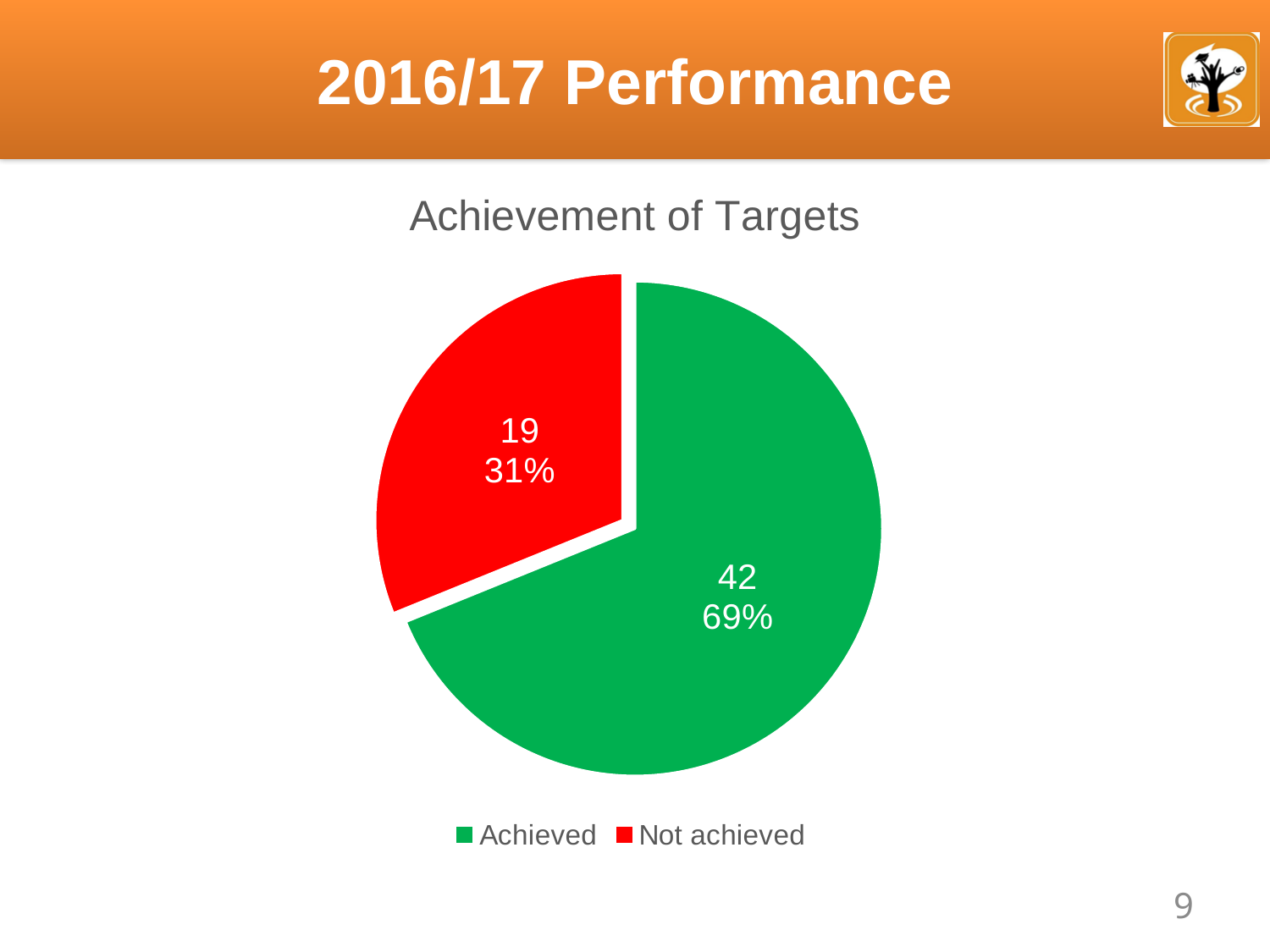
What share of the pie does the 'Not achieved' slice represent? 31% What is the difference between the number of targets achieved and not achieved? 23 Which is larger, the number of targets achieved or not achieved? Achieved What is the title of the chart? Achievement of Targets How many targets were not achieved? 19 Which category is the smallest slice of the pie? Not achieved What percentage of targets were achieved? 69% What colour represents the 'Not achieved' category? red How many targets were achieved? 42 Which category is the largest slice of the pie? Achieved How many categories does the pie chart have? 2 What type of chart is shown on the slide? pie chart